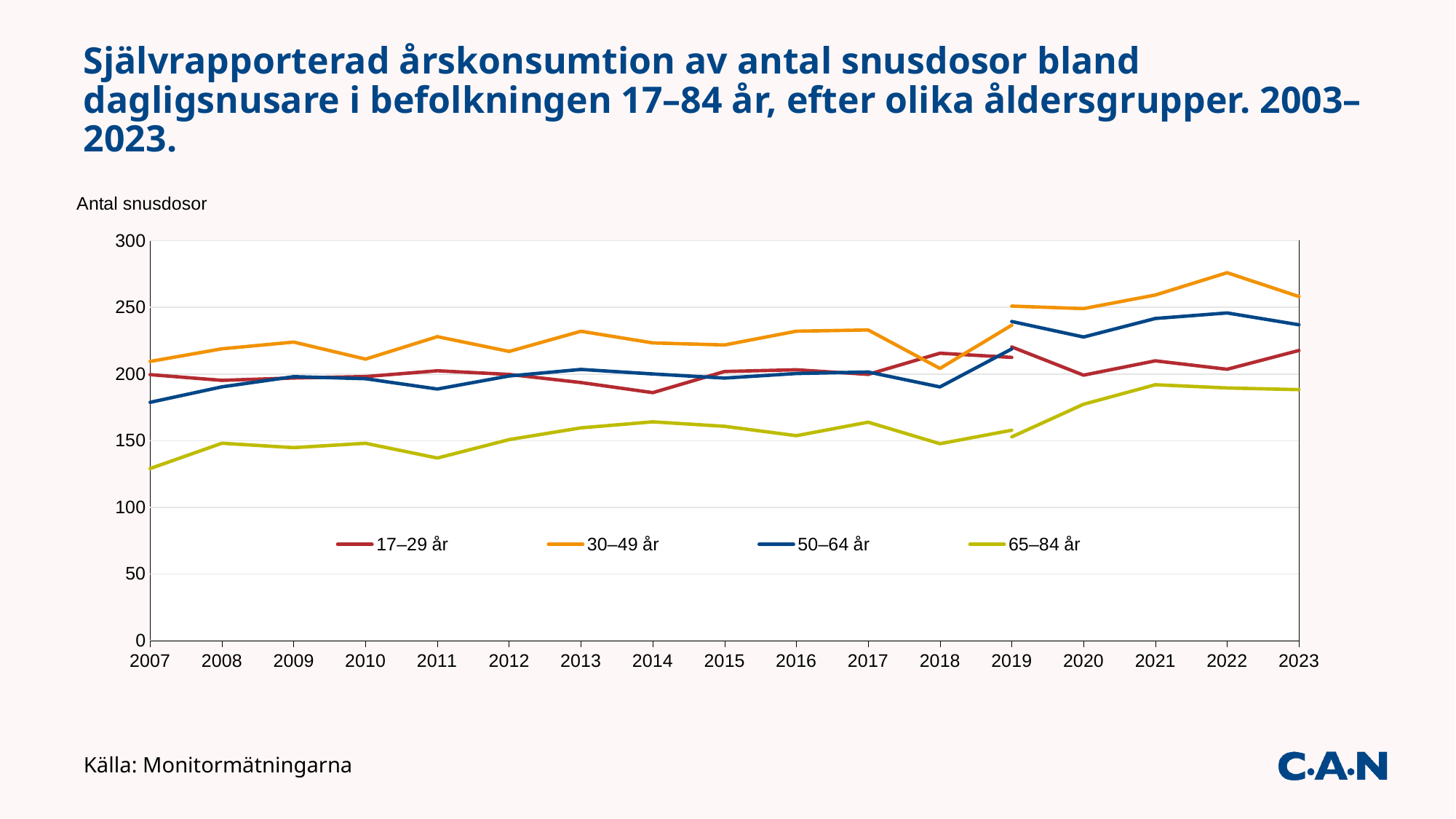
What is the label on the y axis of the chart? Antal snusdosor Is the value for 65–84 år in 2007 greater or less than 150? less What kind of chart is shown on the slide? line chart Which age group has the lowest value in 2007? 65–84 år In 2023, which is larger: the value for 30–49 år or the value for 65–84 år? 30–49 år Does the 30–49 år line rise or fall between 2019 and 2022? rise Is the value for 17–29 år in 2014 greater or less than 200? less How many series does the legend list? 4 Is the value for 50–64 år in 2007 greater or less than 200? less Which age group has the highest value in 2022? 30–49 år How many years are shown along the x axis? 17